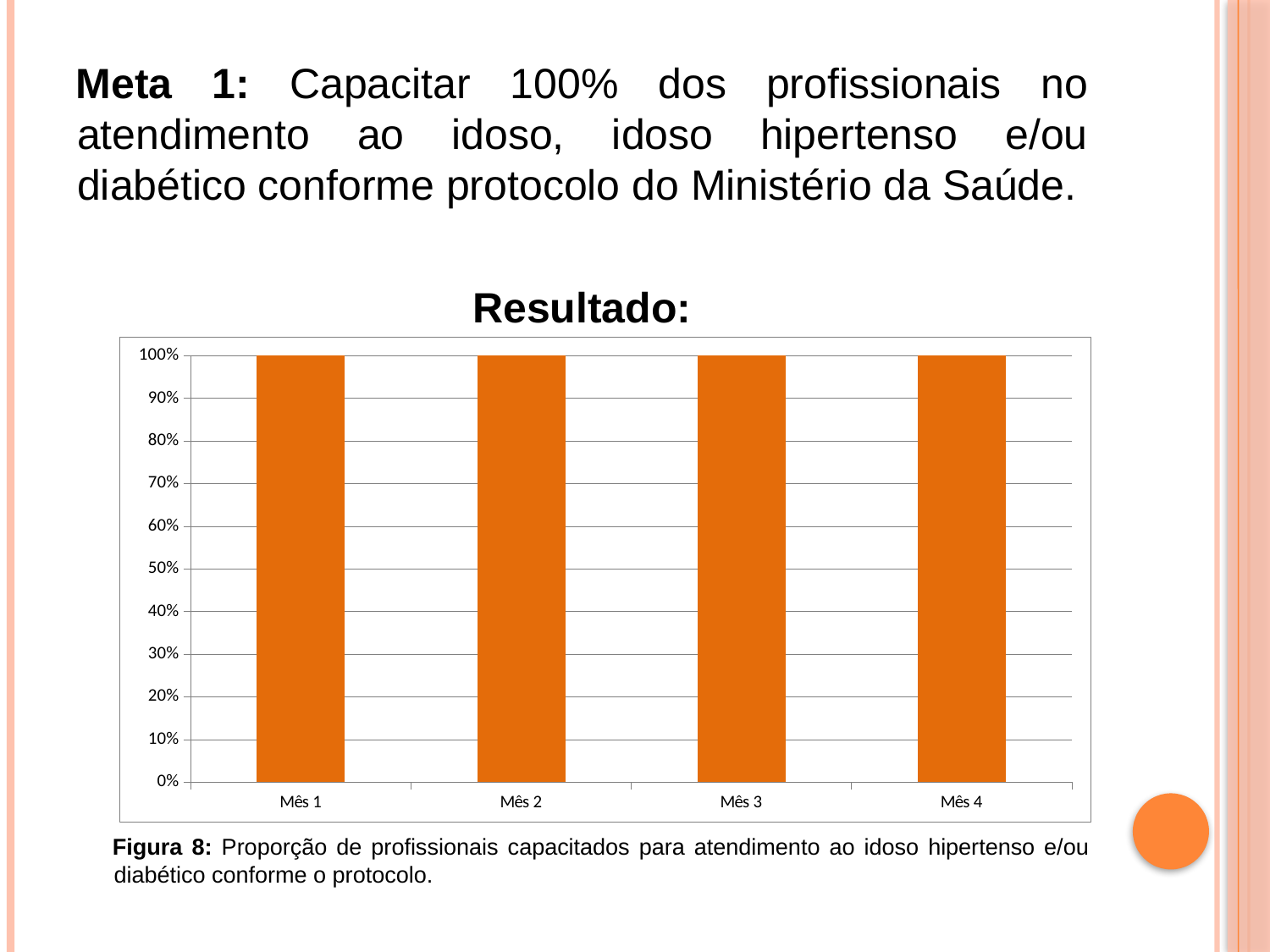
What kind of chart is shown on the slide? bar chart Do the values rise, fall, or stay the same from Mês 1 to Mês 4? stay the same What is the value for Mês 4 in the chart? 100% What is the label of the first category on the x axis? Mês 1 What is the value for Mês 3 in the chart? 100% What is the difference between the values for Mês 1 and Mês 4? 0% What is the value for Mês 1 in the chart? 100% Is the value for Mês 2 greater or less than 50%? greater How many categories (months) are shown on the x axis of the chart? 4 What colour are the bars in the chart? orange What is the highest value shown on the y axis of the chart? 100%